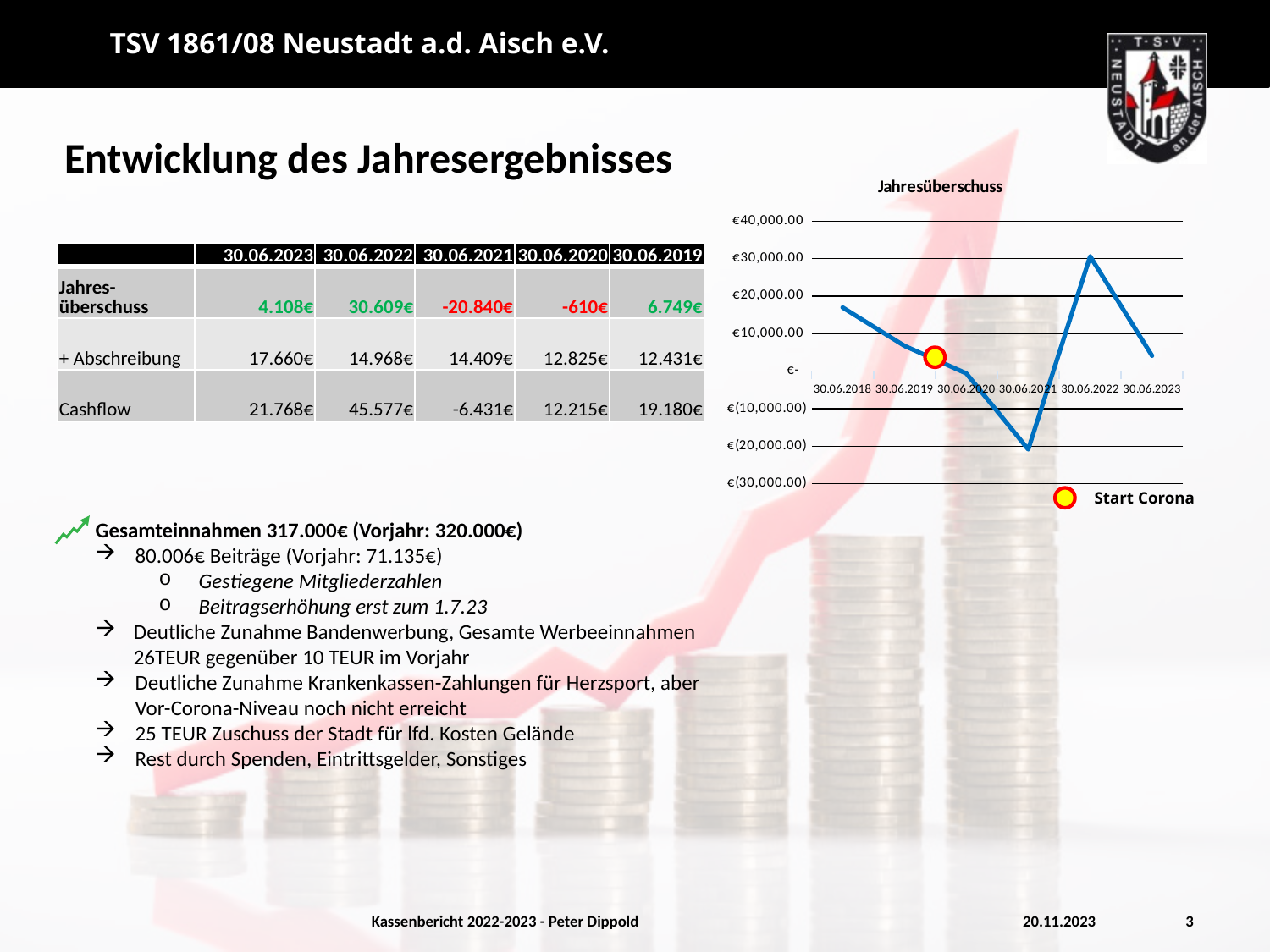
What is the title of the chart? Jahresüberschuss Is the value for 30.06.2023 greater or less than €10,000.00? less Is the value for 30.06.2021 greater or less than €(10,000.00)? less How many data points are plotted on the chart? 6 At which date does the chart reach its highest value? 30.06.2022 Is the value for 30.06.2022 greater or less than €20,000.00? greater What does the yellow circle marker on the chart indicate, according to the label below the chart? Start Corona Do the values rise or fall from 30.06.2018 to 30.06.2021? fall Which is larger, the value for 30.06.2018 or the value for 30.06.2019? 30.06.2018 At which date does the chart reach its lowest value? 30.06.2021 What kind of chart is shown on the slide? line chart